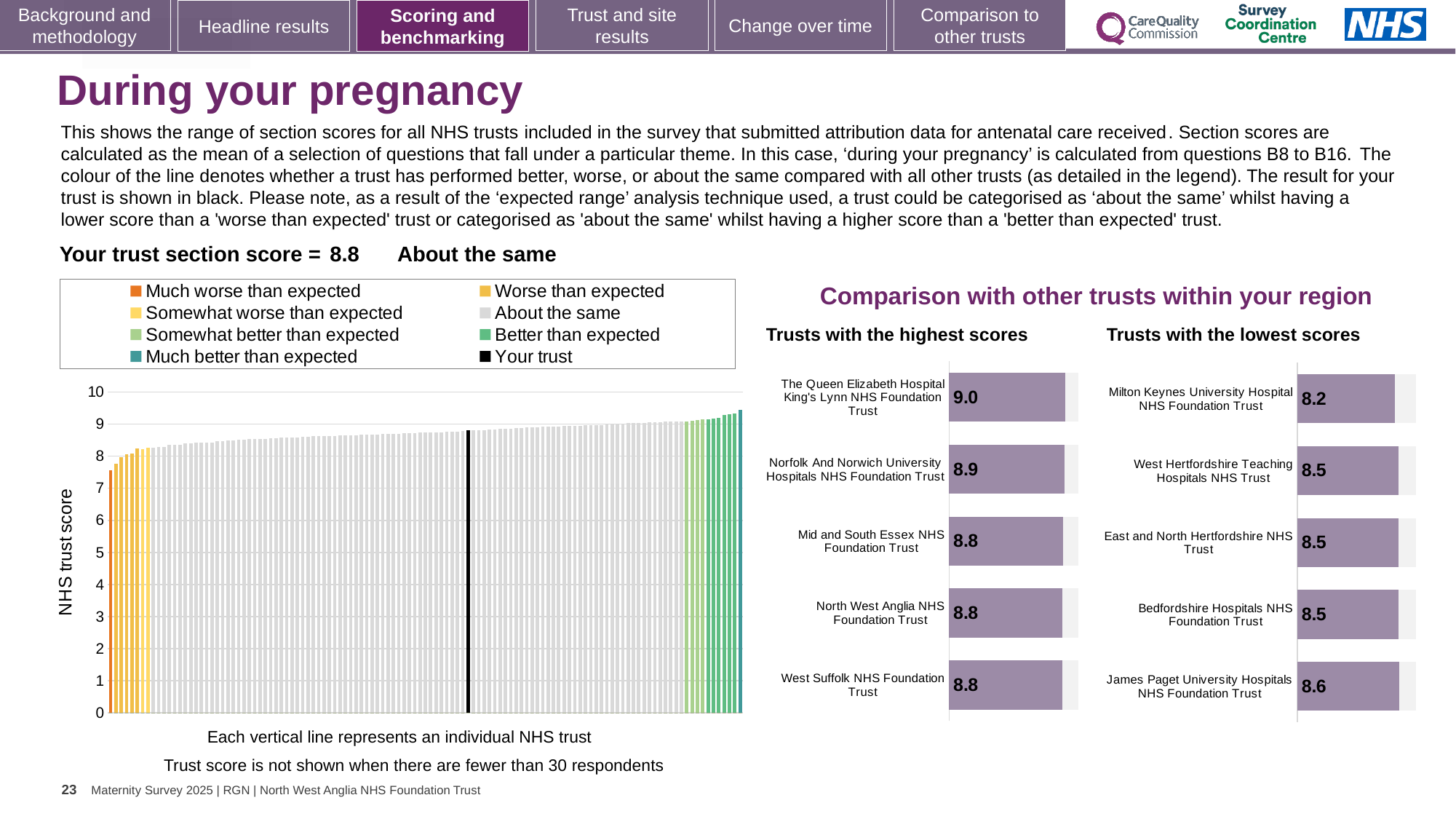
In the large chart on the left, do the bar values rise or fall from left to right along the x axis? rise What kind of chart is the large chart on the left with the y axis labelled 'NHS trust score'? bar chart In the 'Trusts with the lowest scores' chart, what is the difference between James Paget University Hospitals NHS Foundation Trust and Milton Keynes University Hospital NHS Foundation Trust? 0.4 In the large chart on the left, how many entries does the legend list? 8 In the 'Trusts with the highest scores' chart, what is the difference between The Queen Elizabeth Hospital King's Lynn NHS Foundation Trust and Norfolk And Norwich University Hospitals NHS Foundation Trust? 0.1 In the large chart on the left, is the value for the leftmost (orange) bar greater or less than 8? less In the 'Trusts with the highest scores' chart, what is the value for The Queen Elizabeth Hospital King's Lynn NHS Foundation Trust? 9.0 In the 'Trusts with the lowest scores' chart, which is larger: the value for Milton Keynes University Hospital NHS Foundation Trust or the value for James Paget University Hospitals NHS Foundation Trust? James Paget University Hospitals NHS Foundation Trust In the large chart on the left, is the value for the black bar (Your trust) greater or less than 8? greater In the 'Trusts with the highest scores' chart, how many trusts are shown? 5 In the 'Trusts with the lowest scores' chart, which trust has the lowest score? Milton Keynes University Hospital NHS Foundation Trust In the 'Trusts with the lowest scores' chart, what is the value for James Paget University Hospitals NHS Foundation Trust? 8.6